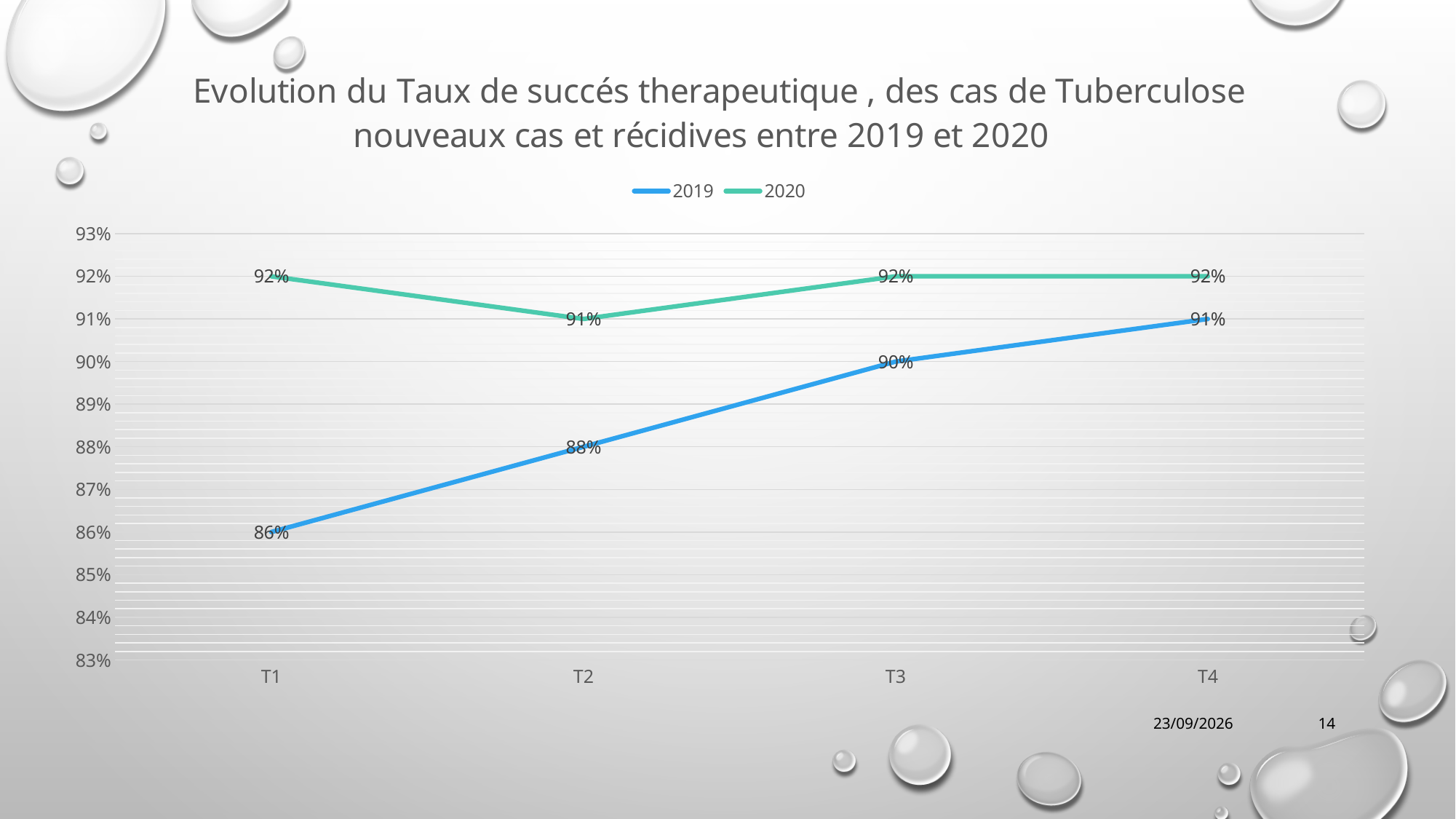
What kind of chart is shown on the slide? Line chart Which series has the higher value at T3, 2019 or 2020? 2020 How many series does the legend list? 2 What is the difference between the 2020 and 2019 values at T1? 6% At which quarter is the 2019 series lowest? T1 What is the value for 2019 at T1? 86% What is the value for 2020 at T2? 91% Which colour is used for the 2020 series? Green How many quarters are shown on the x axis? 4 Does the 2019 series rise or fall from T1 to T4? Rise At which quarter is the 2020 series lowest? T2 What is the value for 2019 at T4? 91%